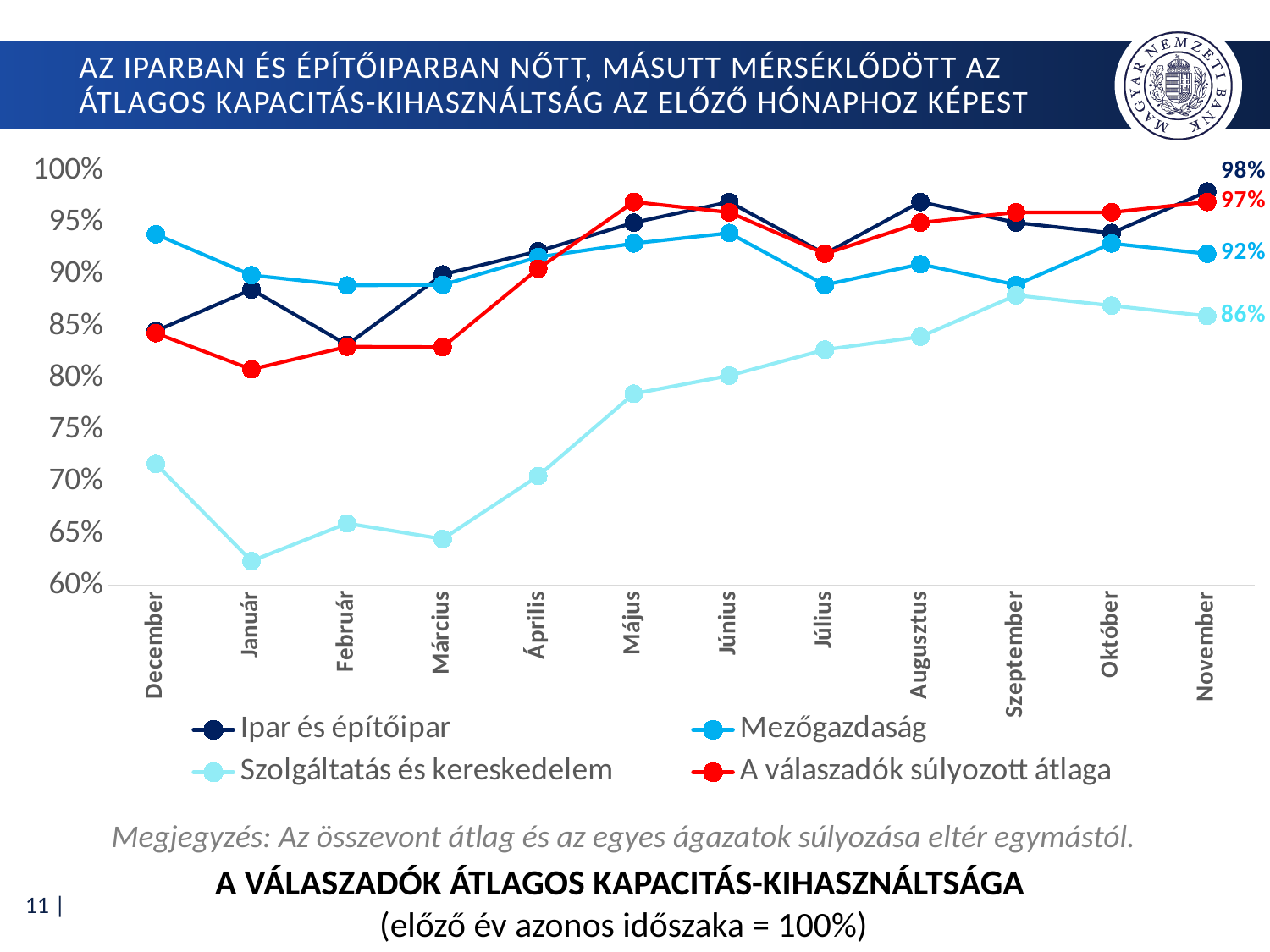
What kind of chart is shown on the slide? Line chart How many months are shown on the x axis? 12 In November, what is the difference between the values for Ipar és építőipar and Szolgáltatás és kereskedelem? 12 percentage points Which series has the lowest value in November? Szolgáltatás és kereskedelem What is the value for A válaszadók súlyozott átlaga in November? 97% How many series does the legend list? 4 What is the value for Szolgáltatás és kereskedelem in November? 86% Is the value for Szolgáltatás és kereskedelem in Január greater or less than 65%? less Which series has the highest value in November? Ipar és építőipar What is the value for Mezőgazdaság in November? 92% In which month does Szolgáltatás és kereskedelem reach its lowest value? Január What is the value for Ipar és építőipar in November? 98%